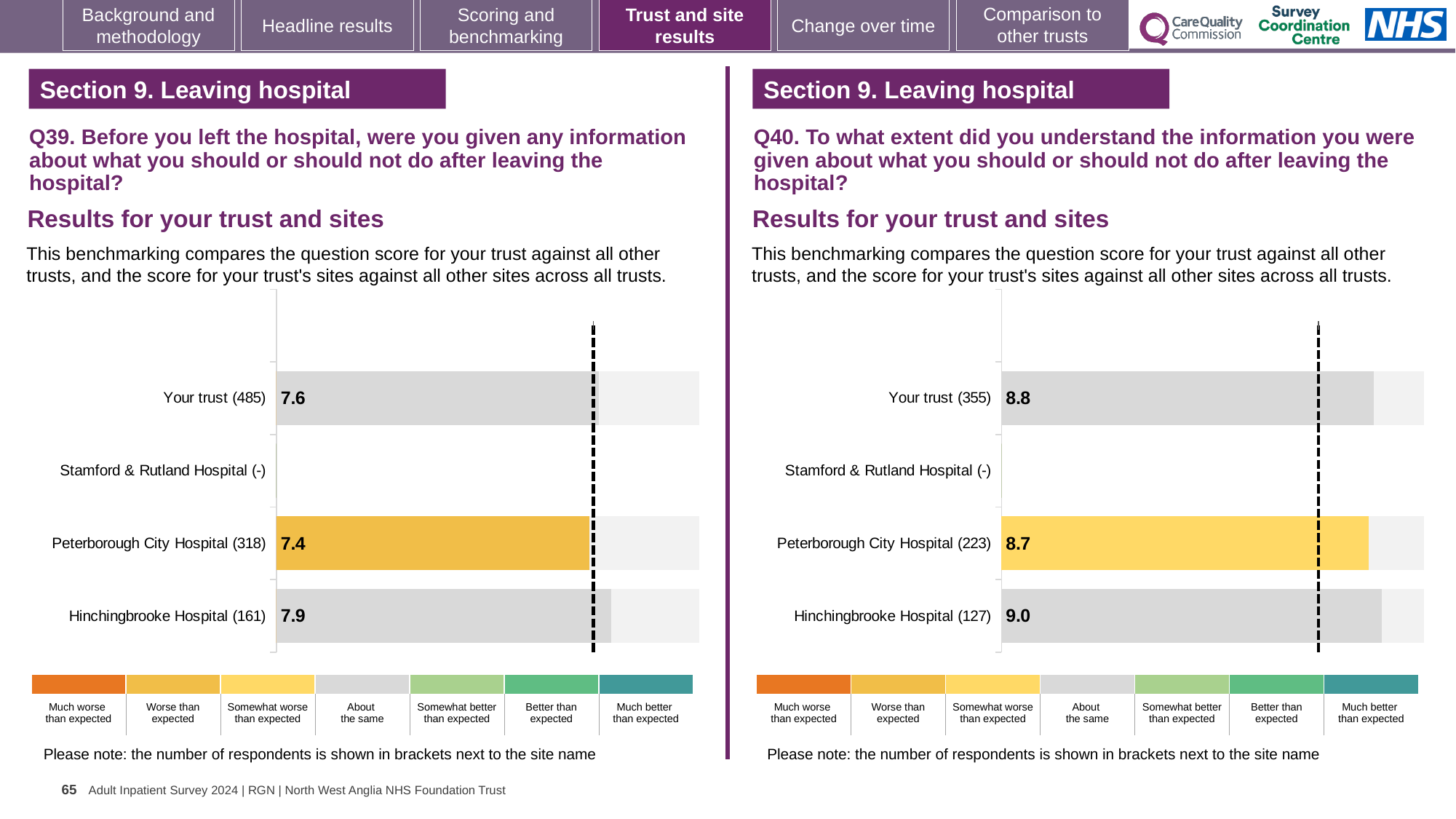
In the Q39 chart on the left, how many respondents are shown in brackets for Your trust? 485 In the Q39 chart on the left, which site or trust has the highest score? Hinchingbrooke Hospital Is the score for Your trust higher in the Q39 chart on the left or the Q40 chart on the right? Q40 chart on the right In the Q39 chart on the left, what is the score for Your trust? 7.6 In the Q40 chart on the right, what is the difference between the scores for Your trust and Peterborough City Hospital? 0.1 In the Q39 chart on the left, what is the score for Peterborough City Hospital? 7.4 In the Q39 chart on the left, what is the difference between the scores for Hinchingbrooke Hospital and Peterborough City Hospital? 0.5 In the Q40 chart on the right, what is the score for Hinchingbrooke Hospital? 9.0 In the Q39 chart on the left, which site has no score shown, marked with (-)? Stamford & Rutland Hospital In the Q40 chart on the right, which site or trust has the lowest score shown? Peterborough City Hospital In the Q40 chart on the right, what is the score for Peterborough City Hospital? 8.7 What type of chart is used in the Q39 chart on the left? Bar chart